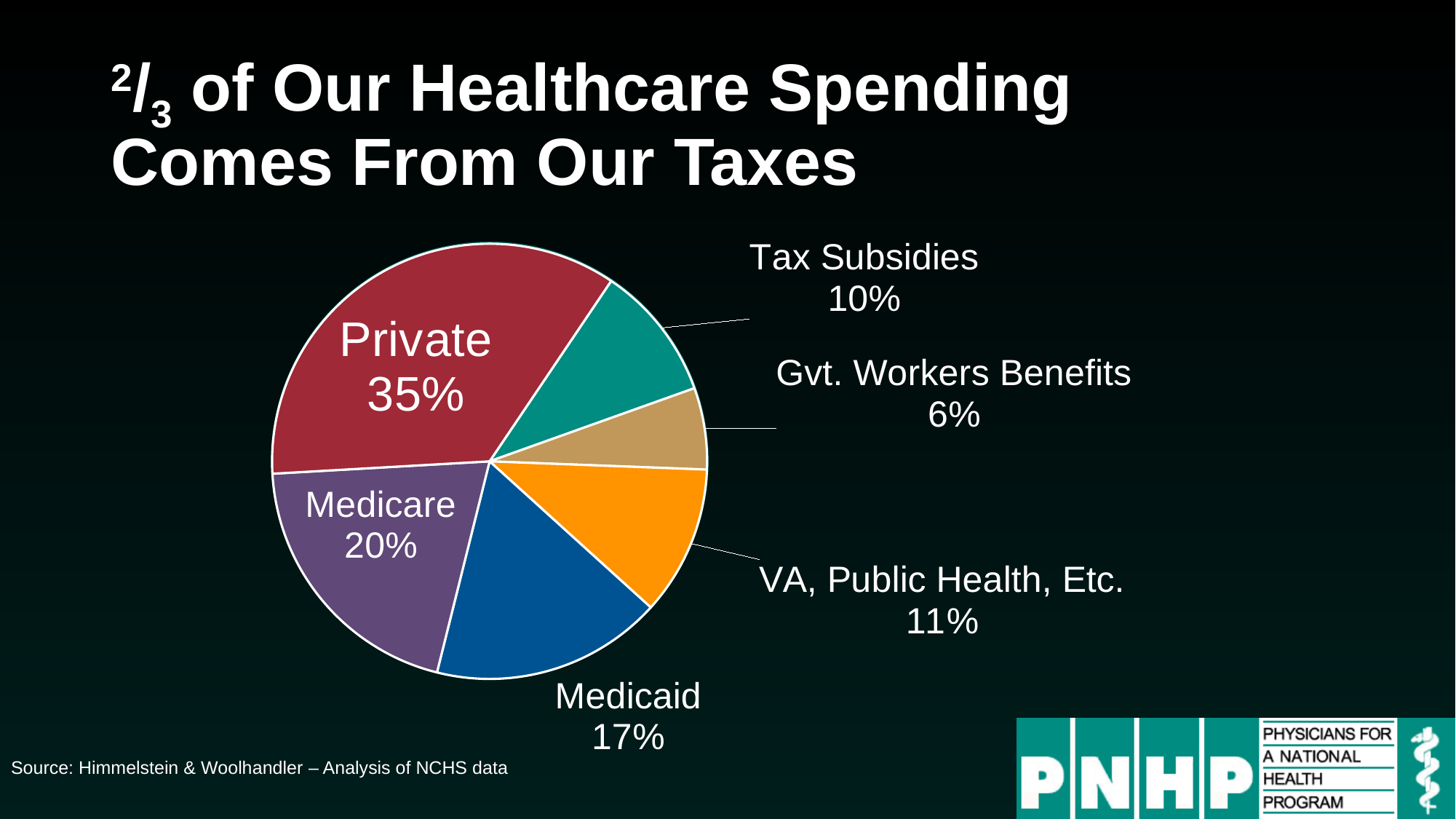
What percentage is shown for Gvt. Workers Benefits? 6% Which slice of the pie chart is the largest? Private What share of healthcare spending comes from Private sources according to the pie chart? 35% What percentage does the Medicare slice represent? 20% Which is larger, the Medicaid slice or the VA, Public Health, Etc. slice? Medicaid What percentage is shown for Tax Subsidies? 10% What is the difference in percentage points between the Private and Medicare slices? 15 How many slices does the pie chart have? 6 Which slice of the pie chart is the smallest? Gvt. Workers Benefits What percentage is shown for Medicaid? 17% What kind of chart is shown on the slide? pie chart What is the title of the slide containing the pie chart? 2/3 of Our Healthcare Spending Comes From Our Taxes